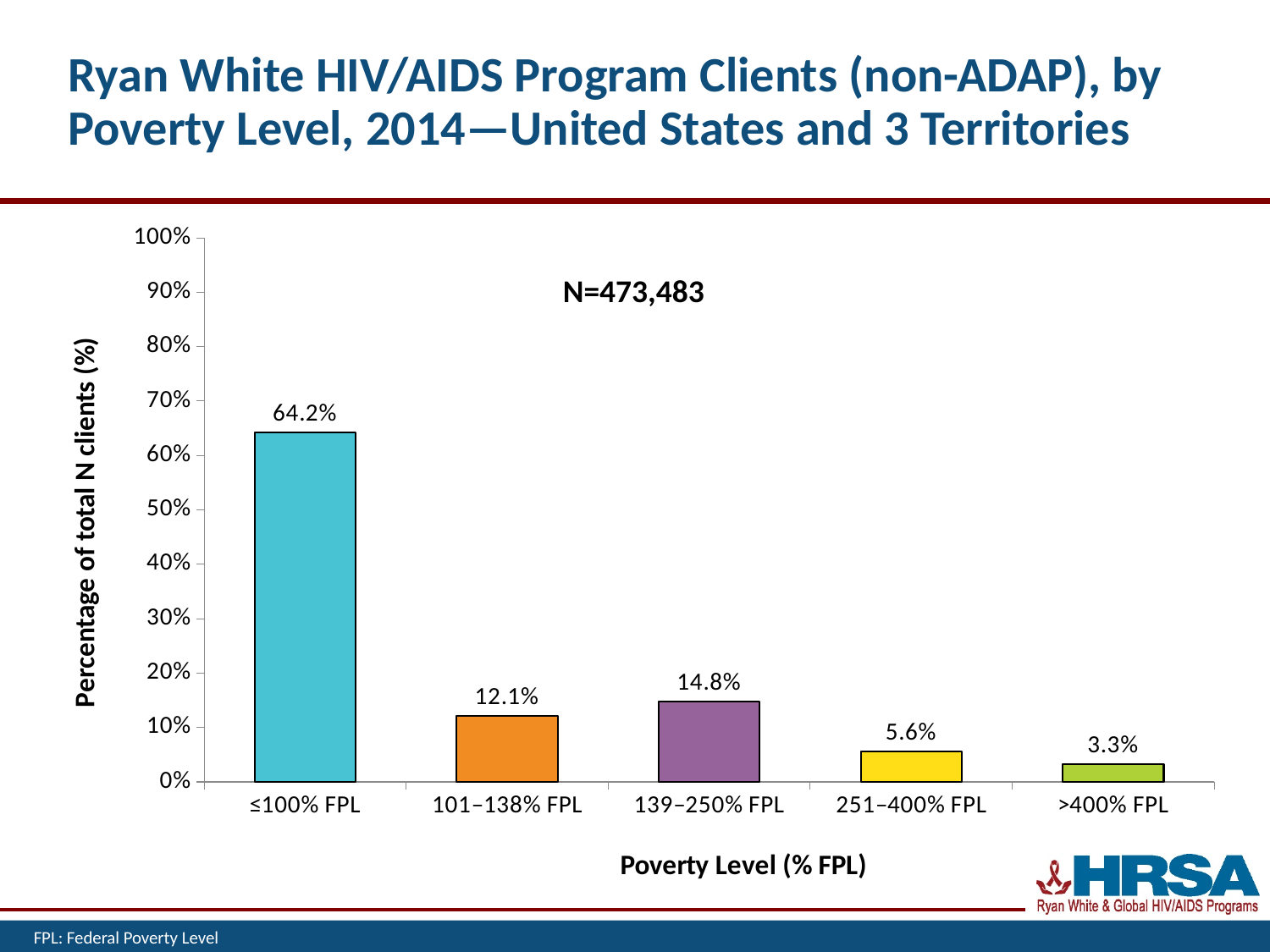
Which is larger, the value for 251–400% FPL or the value for >400% FPL? 251–400% FPL What is the value for the 139–250% FPL category? 14.8% Which poverty level category has the highest percentage of clients? ≤100% FPL How many poverty level categories are shown on the x axis? 5 What is the label of the x axis? Poverty Level (% FPL) What percentage of clients are at ≤100% FPL? 64.2% Is the value for ≤100% FPL greater or less than 60%? greater Which poverty level category has the lowest percentage of clients? >400% FPL What kind of chart is shown on the slide? bar chart What is the total N of clients stated on the chart? N=473,483 What is the difference between the values for 139–250% FPL and 101–138% FPL? 2.7% What percentage of clients are at >400% FPL? 3.3%